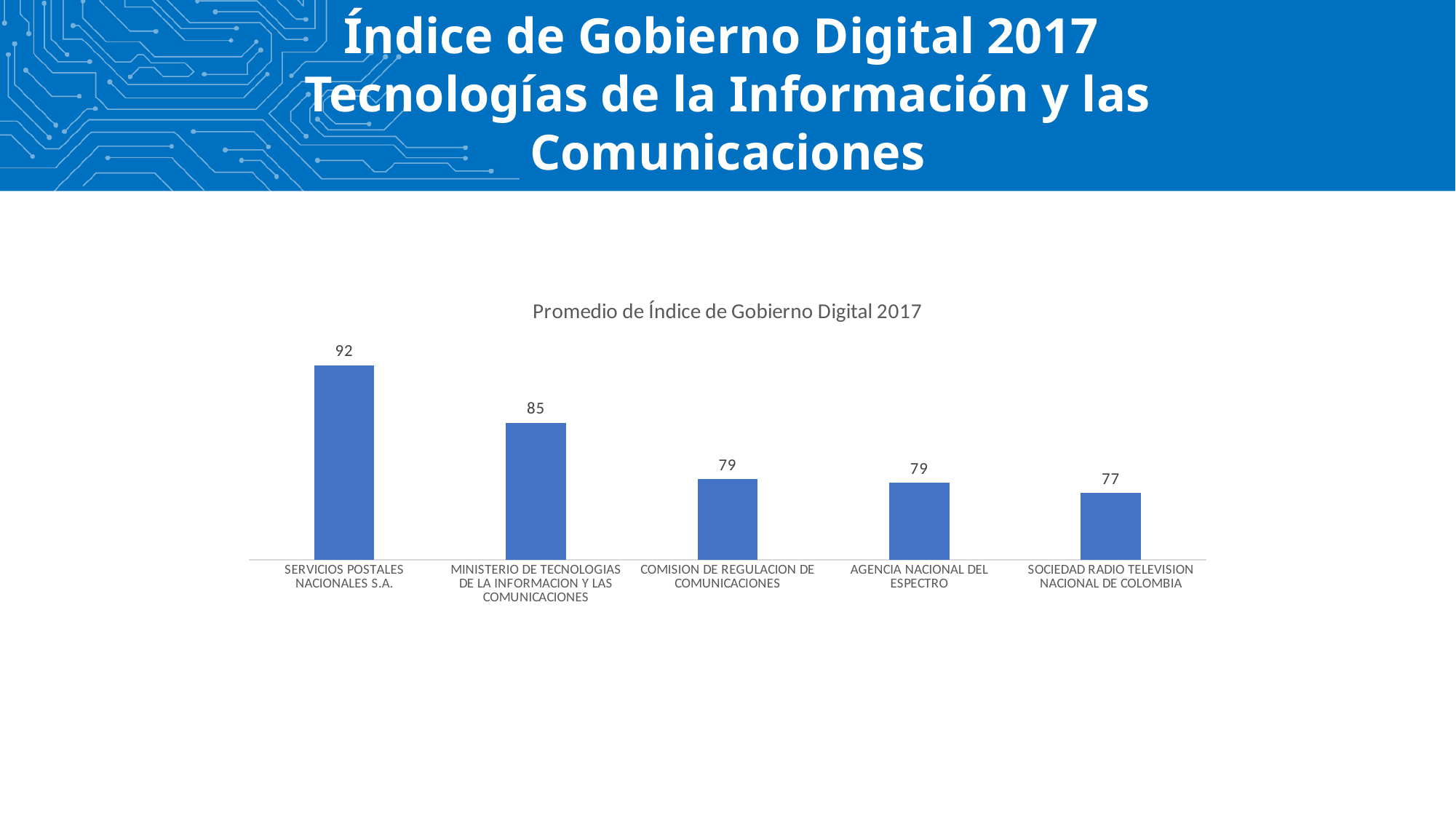
What is the difference between the values for MINISTERIO DE TECNOLOGIAS DE LA INFORMACION Y LAS COMUNICACIONES and COMISION DE REGULACION DE COMUNICACIONES? 6 Which category has the highest value? SERVICIOS POSTALES NACIONALES S.A. What is the difference between the values for SERVICIOS POSTALES NACIONALES S.A. and SOCIEDAD RADIO TELEVISION NACIONAL DE COLOMBIA? 15 What is the value for MINISTERIO DE TECNOLOGIAS DE LA INFORMACION Y LAS COMUNICACIONES? 85 What is the title of the chart? Promedio de Índice de Gobierno Digital 2017 Which is larger, the value for SERVICIOS POSTALES NACIONALES S.A. or the value for MINISTERIO DE TECNOLOGIAS DE LA INFORMACION Y LAS COMUNICACIONES? SERVICIOS POSTALES NACIONALES S.A. Which category has the lowest value? SOCIEDAD RADIO TELEVISION NACIONAL DE COLOMBIA How many categories are shown in the chart? 5 What is the value for SOCIEDAD RADIO TELEVISION NACIONAL DE COLOMBIA? 77 What kind of chart is shown on the slide? Bar chart What is the value for SERVICIOS POSTALES NACIONALES S.A.? 92 What is the value for AGENCIA NACIONAL DEL ESPECTRO? 79